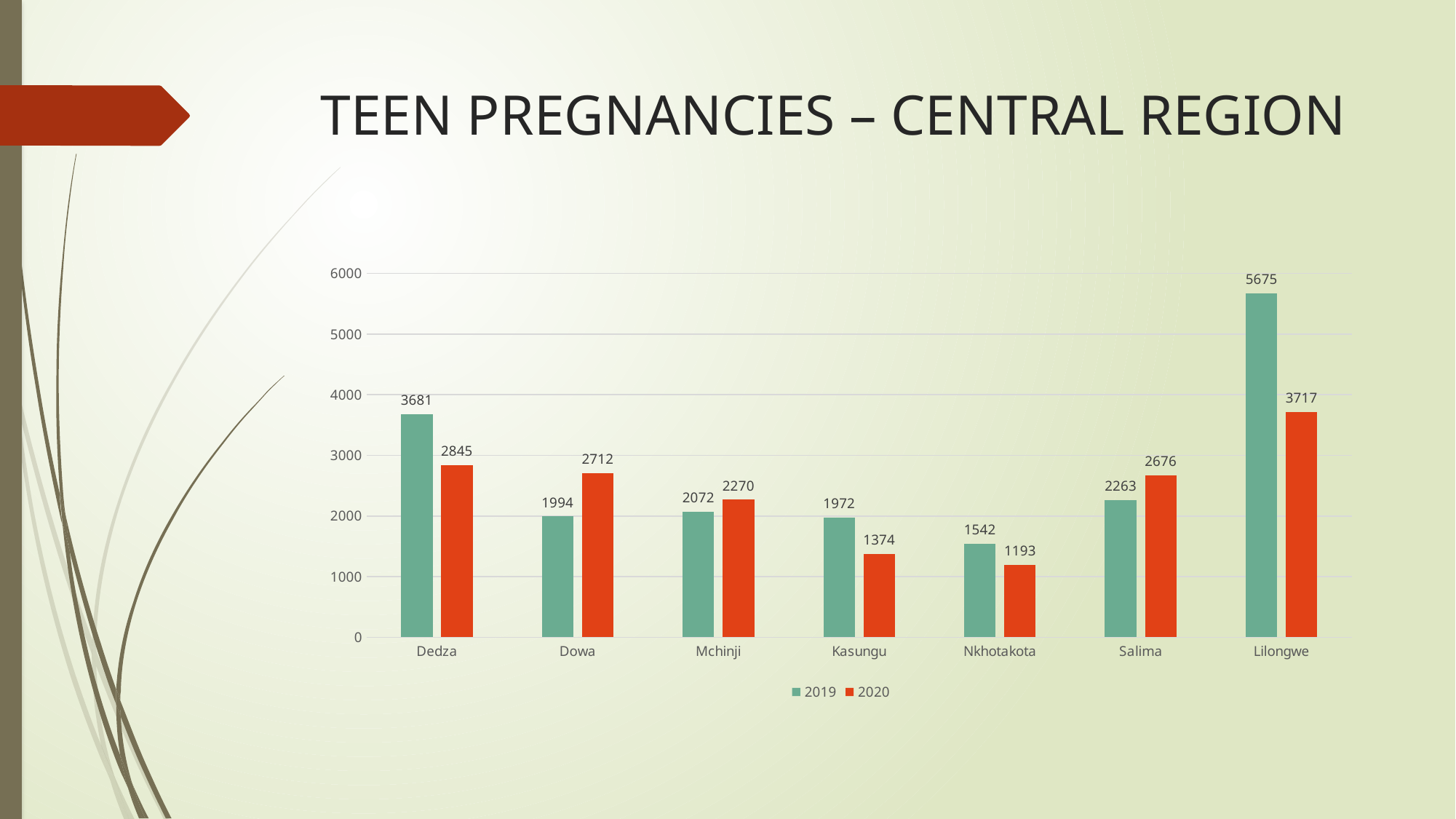
What kind of chart is shown on the slide? bar chart Which district had the highest number of teen pregnancies in 2019? Lilongwe How many districts are shown on the x axis? 7 Which is larger for Salima: the 2019 value or the 2020 value? 2020 What was the number of teen pregnancies in Dedza in 2019? 3681 Which district had the lowest number of teen pregnancies in 2020? Nkhotakota How many series does the legend list? 2 What was the number of teen pregnancies in Nkhotakota in 2020? 1193 What is the title of the slide? TEEN PREGNANCIES – CENTRAL REGION Is the 2019 value for Kasungu greater or less than 2000? less What is the difference between the 2019 and 2020 values for Lilongwe? 1958 What was the number of teen pregnancies in Lilongwe in 2020? 3717